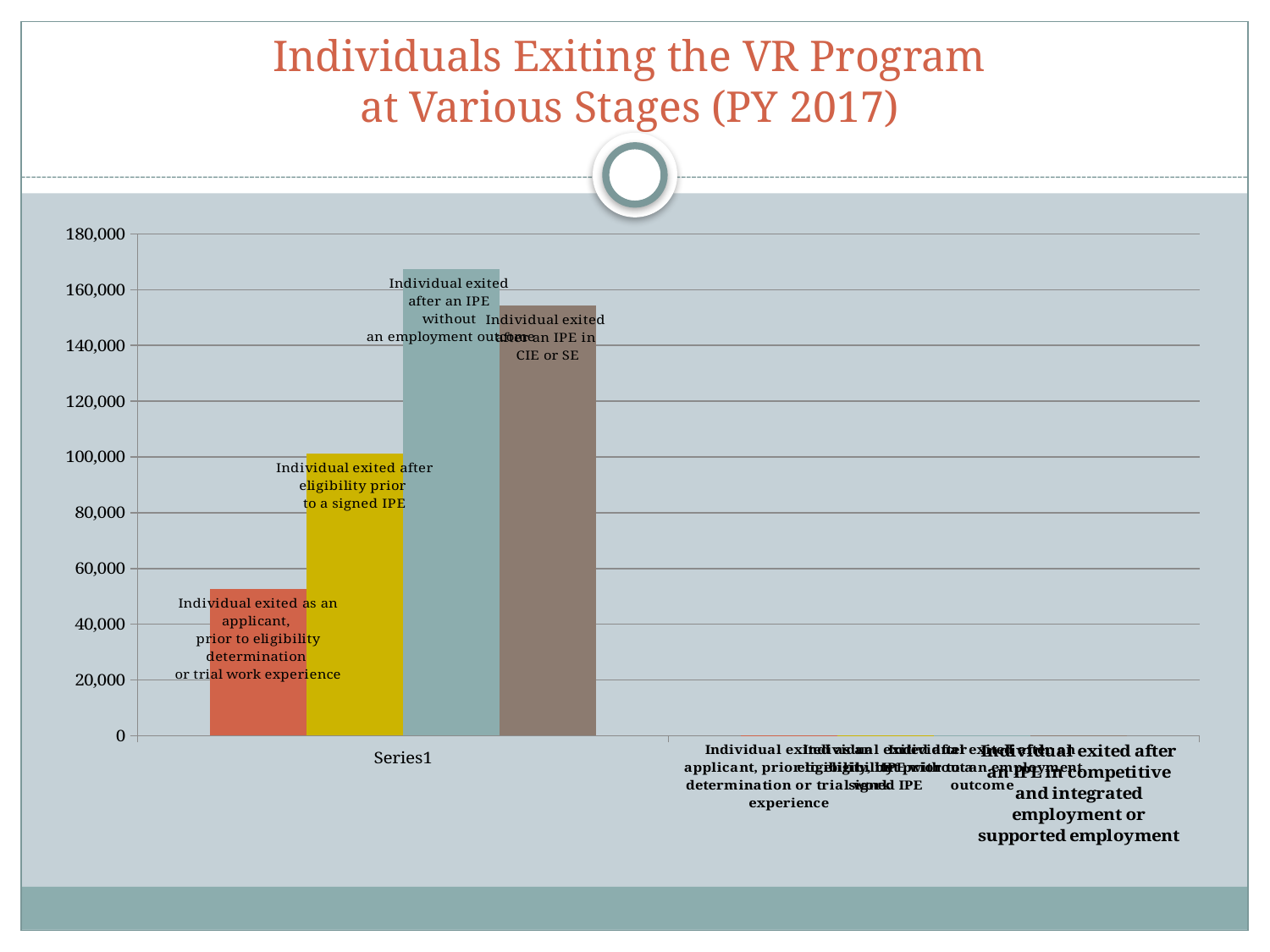
Is the value for individuals who exited after an IPE without an employment outcome greater or less than 160,000? greater Is the value for individuals who exited after eligibility prior to a signed IPE greater or less than 120,000? less What is the title of the chart on the slide? Individuals Exiting the VR Program at Various Stages (PY 2017) What kind of chart is shown on the slide? bar chart Which category has the tallest bar? Individual exited after an IPE without an employment outcome What is the highest value shown on the vertical axis? 180,000 Which category has the shortest bar? Individual exited as an applicant, prior to eligibility determination or trial work experience Is the value for individuals who exited as an applicant, prior to eligibility determination or trial work experience, greater or less than 60,000? less How many bars are plotted in the chart? 4 Which is larger: the bar for individuals who exited after eligibility prior to a signed IPE, or the bar for individuals who exited after an IPE in CIE or SE? Individual exited after an IPE in CIE or SE Which is larger: the bar for individuals who exited as an applicant prior to eligibility determination, or the bar for individuals who exited after eligibility prior to a signed IPE? Individual exited after eligibility prior to a signed IPE